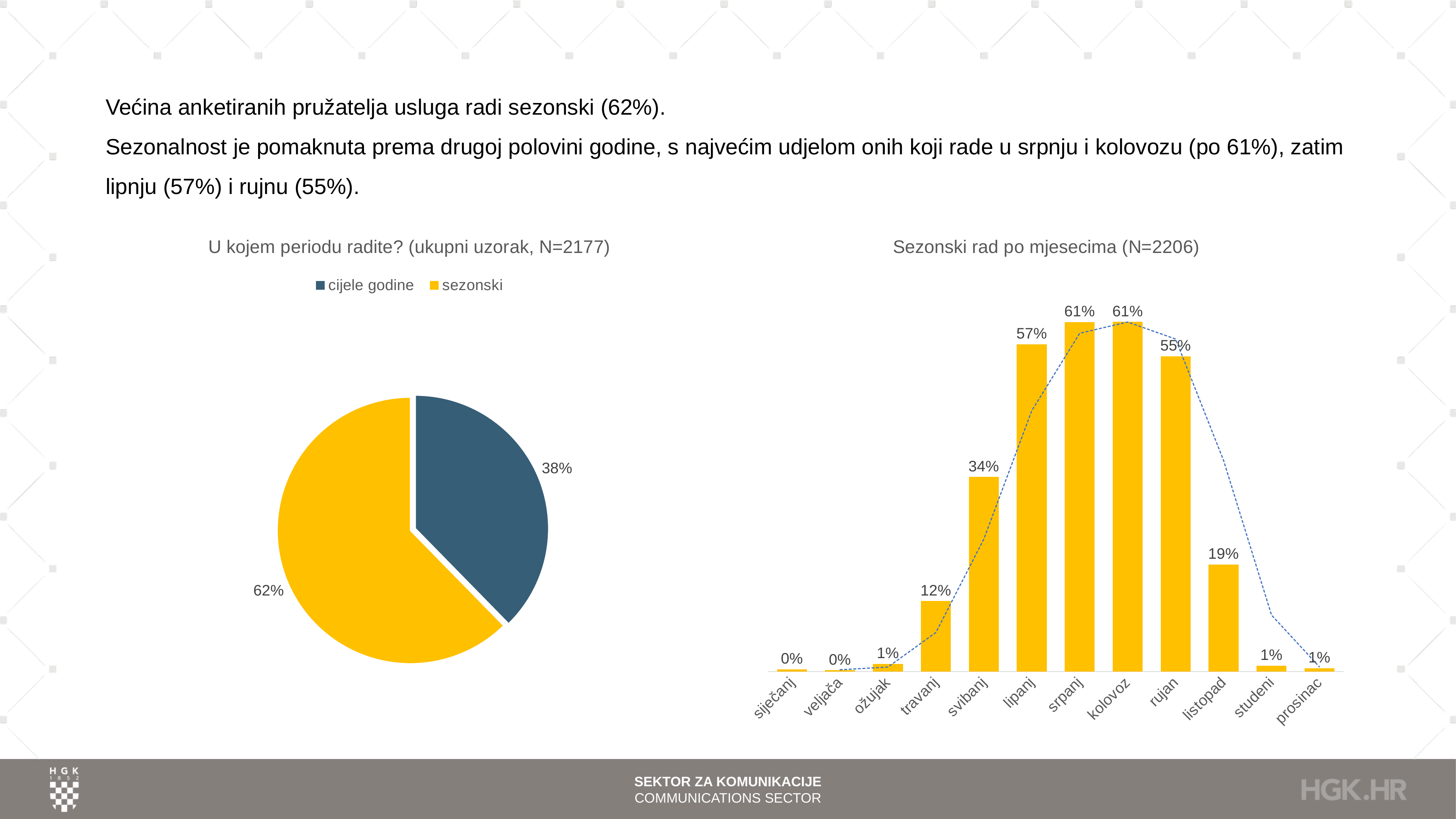
In the chart 'Sezonski rad po mjesecima (N=2206)', what is the value for 'lipanj'? 57% In the pie chart 'U kojem periodu radite? (ukupni uzorak, N=2177)', how many entries does the legend list? 2 In the chart 'Sezonski rad po mjesecima (N=2206)', what is the value for 'svibanj'? 34% In the pie chart 'U kojem periodu radite? (ukupni uzorak, N=2177)', what share is labelled for 'sezonski'? 62% In the chart 'Sezonski rad po mjesecima (N=2206)', which month has the lowest value among 'travanj', 'svibanj' and 'lipanj'? travanj How many months are shown on the x axis of the chart 'Sezonski rad po mjesecima (N=2206)'? 12 What kind of chart is 'Sezonski rad po mjesecima (N=2206)'? bar chart In the chart 'Sezonski rad po mjesecima (N=2206)', what is the value for 'listopad'? 19% In the pie chart 'U kojem periodu radite? (ukupni uzorak, N=2177)', what share is labelled for 'cijele godine'? 38% In the chart 'Sezonski rad po mjesecima (N=2206)', what is the difference between the values for 'srpanj' and 'rujan'? 6% What kind of chart is the chart on the left, 'U kojem periodu radite? (ukupni uzorak, N=2177)'? pie chart In the chart 'Sezonski rad po mjesecima (N=2206)', which is larger, the value for 'svibanj' or the value for 'listopad'? svibanj